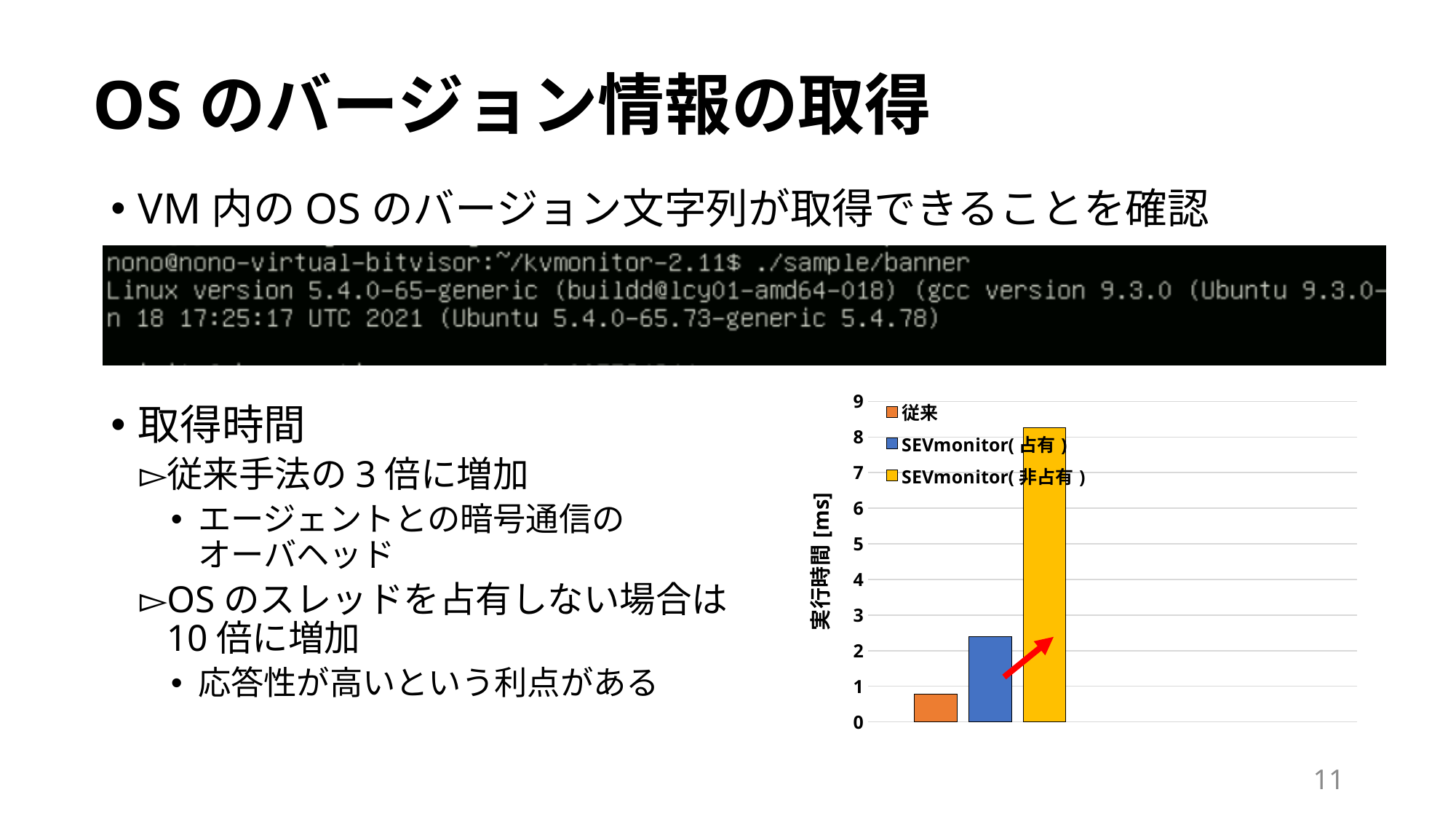
Is the execution time for 従来 greater or less than 1 ms? less Which has a larger execution time, 従来 or SEVmonitor(占有)? SEVmonitor(占有) How many bars are plotted in the chart? 3 What colour is the bar for SEVmonitor(非占有)? yellow Is the execution time for SEVmonitor(占有) greater or less than 2 ms? greater What kind of chart is shown on the slide? bar chart How many series does the chart legend list? 3 Is the execution time for SEVmonitor(占有) greater or less than 3 ms? less Which series has the lowest execution time in the chart? 従来 What is the label of the vertical axis of the chart? 実行時間 [ms] Which series has the highest execution time in the chart? SEVmonitor(非占有)